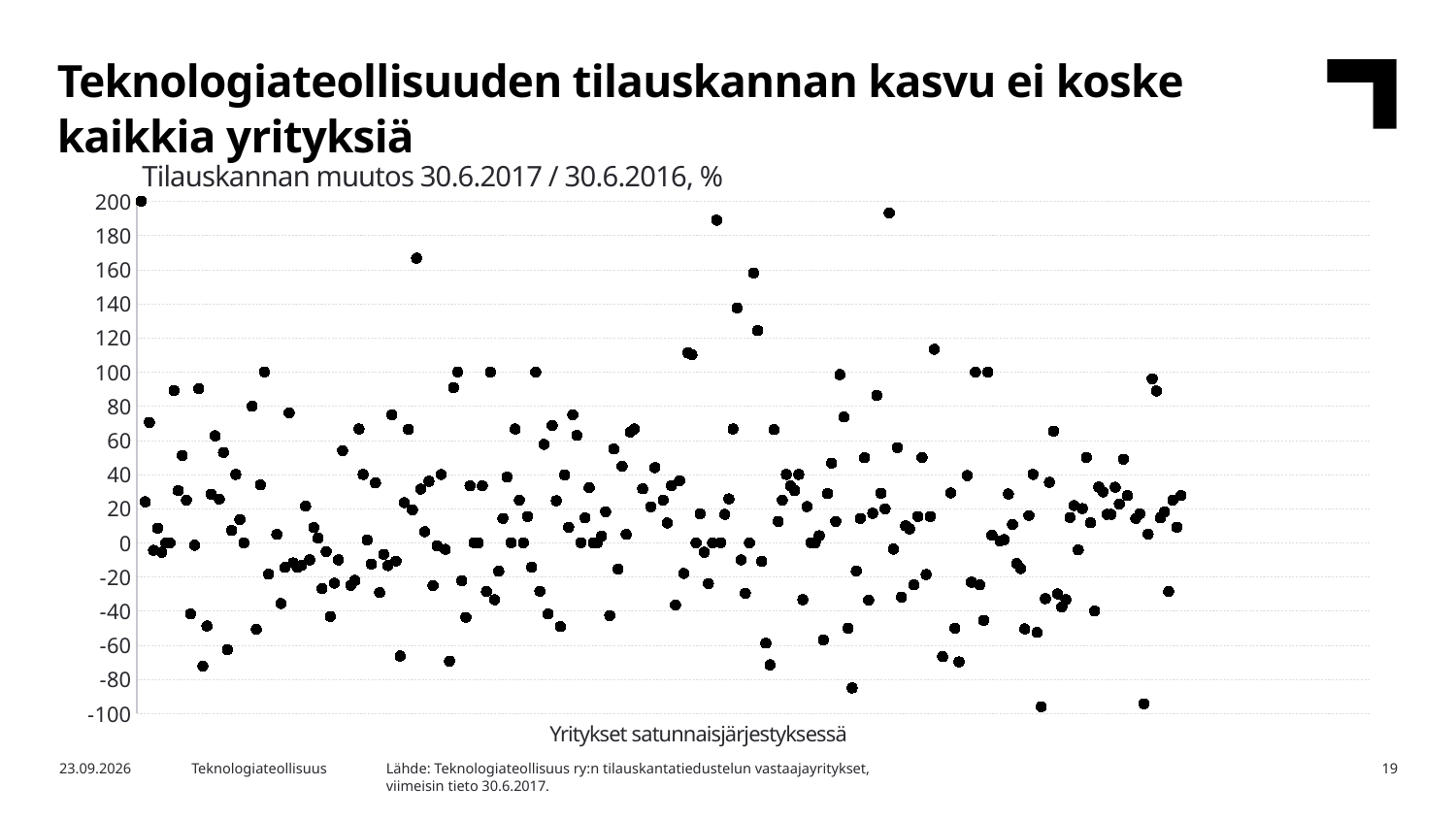
Is the value of the first (leftmost) point in the chart greater or less than 160? greater What is the title of the chart? Tilauskannan muutos 30.6.2017 / 30.6.2016, % What kind of chart is shown on the slide? scatter chart What is the label on the x axis of the chart? Yritykset satunnaisjärjestyksessä Is the highest plotted value in the chart greater or less than 180? greater Is the lowest plotted value in the chart greater or less than -80? less